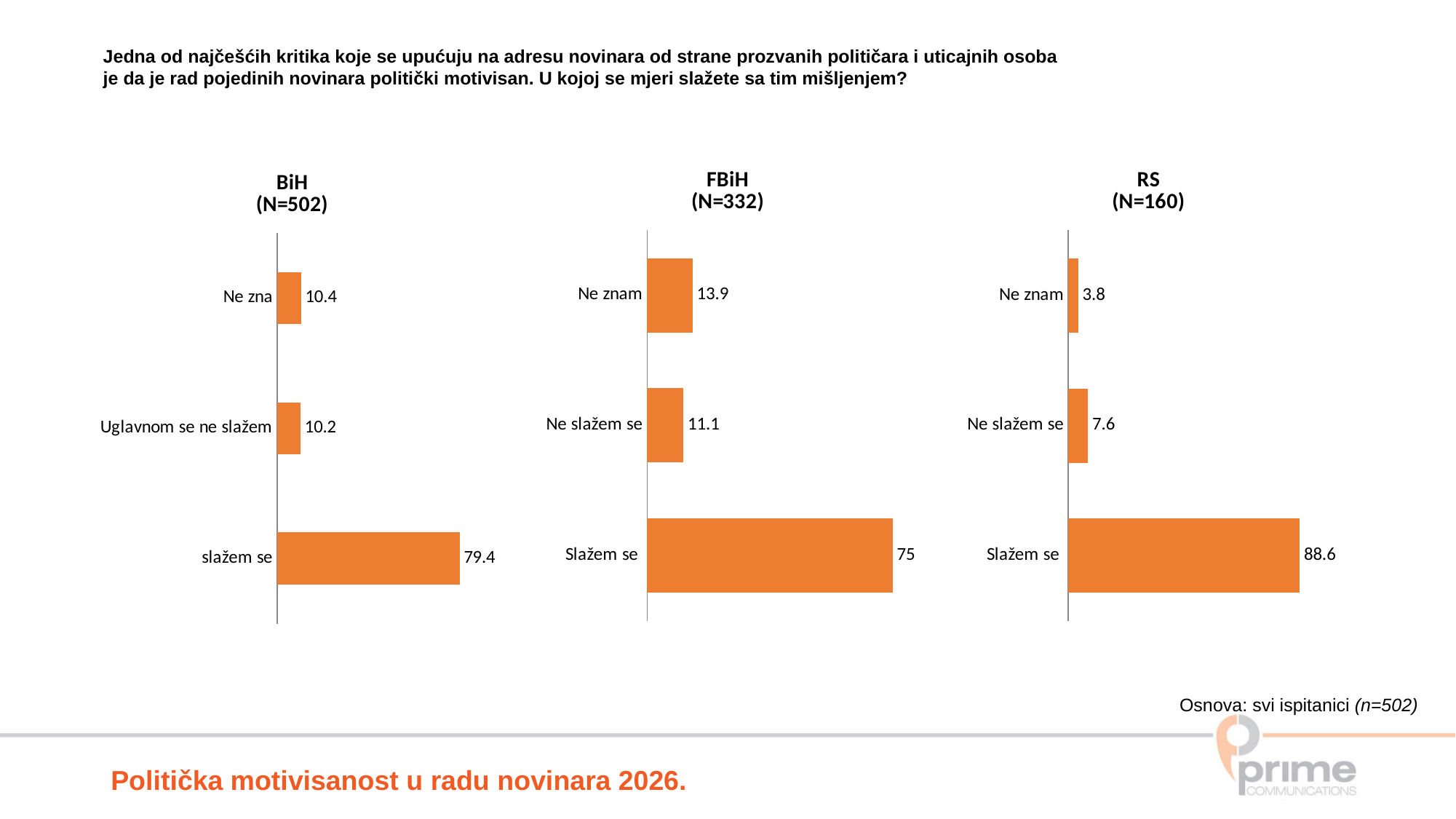
In the FBiH (N=332) chart, what is the value for "Ne znam"? 13.9 In the RS (N=160) chart, which category has the highest value? Slažem se How many categories are shown in the BiH (N=502) chart? 3 In the FBiH (N=332) chart, which is larger: "Ne znam" or "Ne slažem se"? Ne znam Which chart shows the higher value for "Slažem se": FBiH (N=332) or RS (N=160)? RS (N=160) In the FBiH (N=332) chart, what is the difference between "Slažem se" and "Ne znam"? 61.1 In the RS (N=160) chart, what is the value for "Ne slažem se"? 7.6 In the BiH (N=502) chart, what is the value for "slažem se"? 79.4 How many charts are shown on the slide? 3 In the RS (N=160) chart, which category has the lowest value? Ne znam In the RS (N=160) chart, what is the difference between "Slažem se" and "Ne slažem se"? 81 What kind of chart is the FBiH (N=332) chart? Bar chart